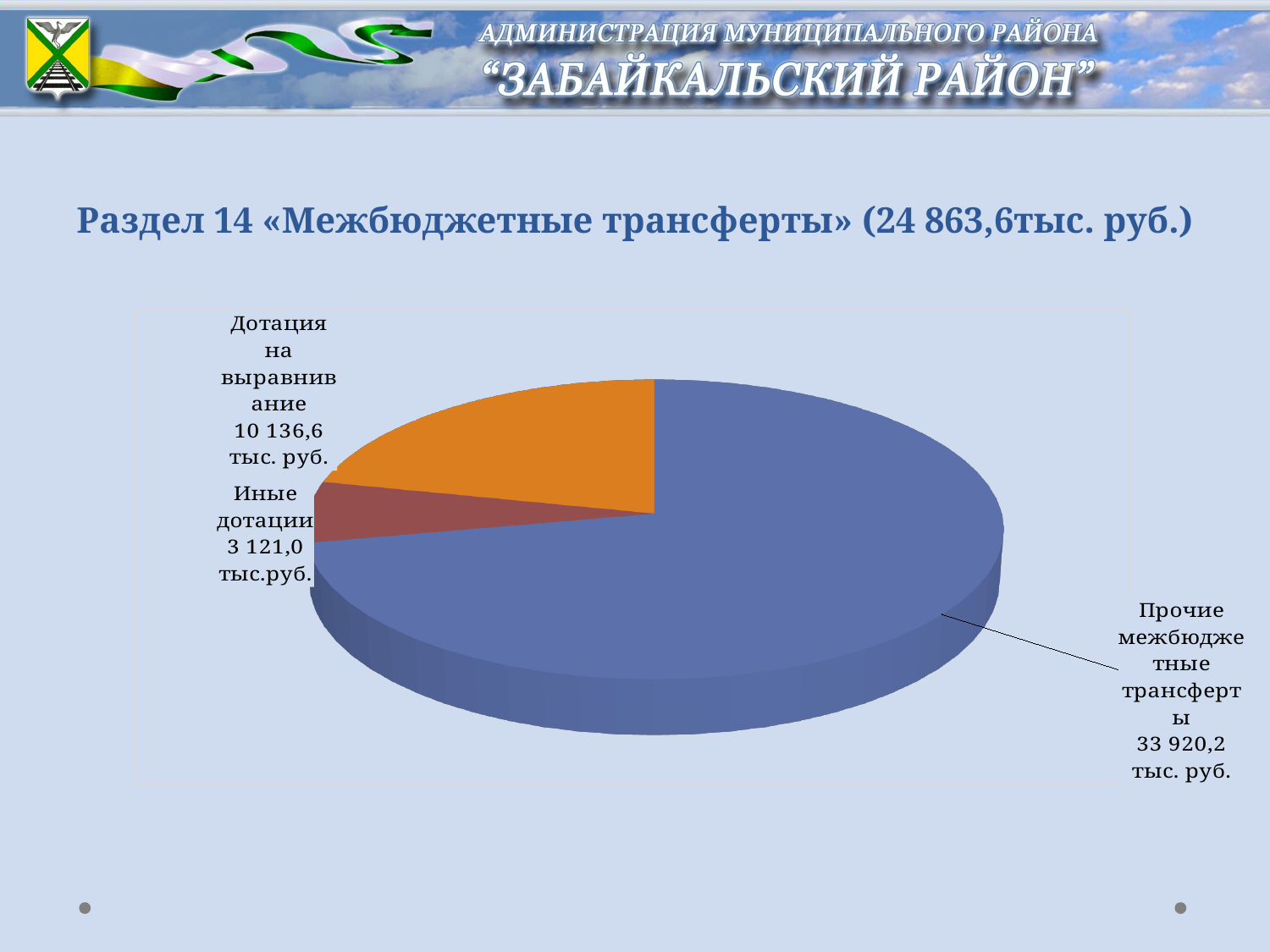
Which slice of the pie chart is the largest? Прочие межбюджетные трансферты What colour is the slice for «Прочие межбюджетные трансферты»? Blue What is the value shown for «Иные дотации»? 3 121,0 тыс.руб. What is the value shown for «Дотация на выравнивание»? 10 136,6 тыс. руб. What is the title of the slide above the chart? Раздел 14 «Межбюджетные трансферты» (24 863,6тыс. руб.) Which slice of the pie chart is the smallest? Иные дотации What kind of chart is shown on the slide? Pie chart What is the value shown for «Прочие межбюджетные трансферты»? 33 920,2 тыс. руб. What is the difference between «Прочие межбюджетные трансферты» and «Дотация на выравнивание»? 23 783,6 тыс. руб. Which is larger: «Дотация на выравнивание» or «Иные дотации»? Дотация на выравнивание What is the difference between «Дотация на выравнивание» and «Иные дотации»? 7 015,6 тыс. руб. How many slices does the pie chart have? 3